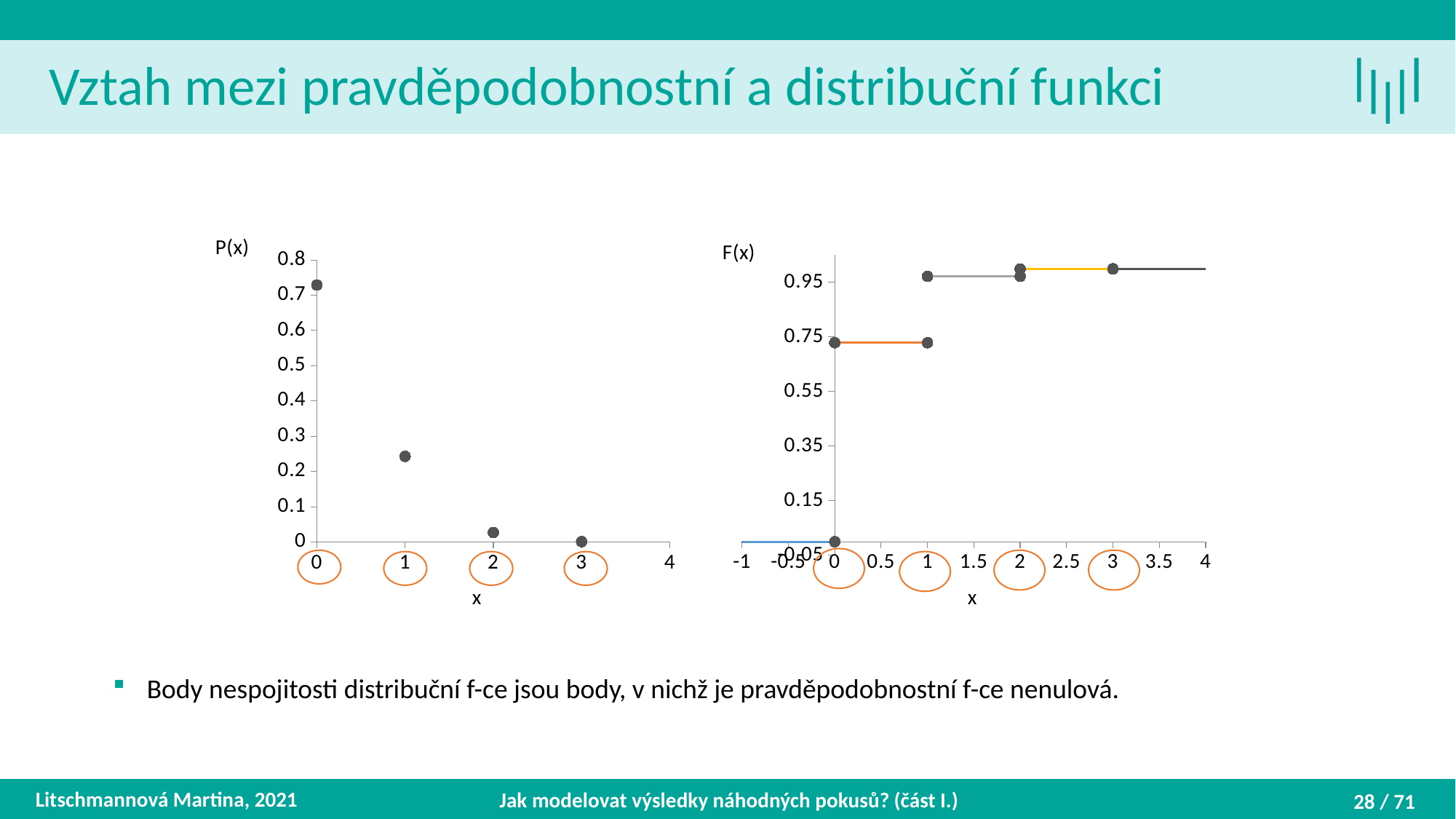
In the right chart (F(x)), is the value at x = 0 greater or less than 0.55? greater In the left chart (P(x)), is the value at x = 2 greater or less than 0.1? less In the left chart (P(x)), is the value at x = 1 greater or less than 0.3? less What kind of chart is the left chart labelled P(x)? scatter chart In the left chart (P(x)), which is larger, the value at x = 0 or the value at x = 1? x = 0 In the right chart (F(x)), do the values rise or fall as x increases? rise In the left chart (P(x)), at which x value is the plotted point lowest? 3 What is the label on the vertical axis of the right chart? F(x) In the left chart (P(x)), do the values rise or fall as x increases? fall In the left chart (P(x)), at which x value is the plotted point highest? 0 How many data points are plotted in the left chart (P(x))? 4